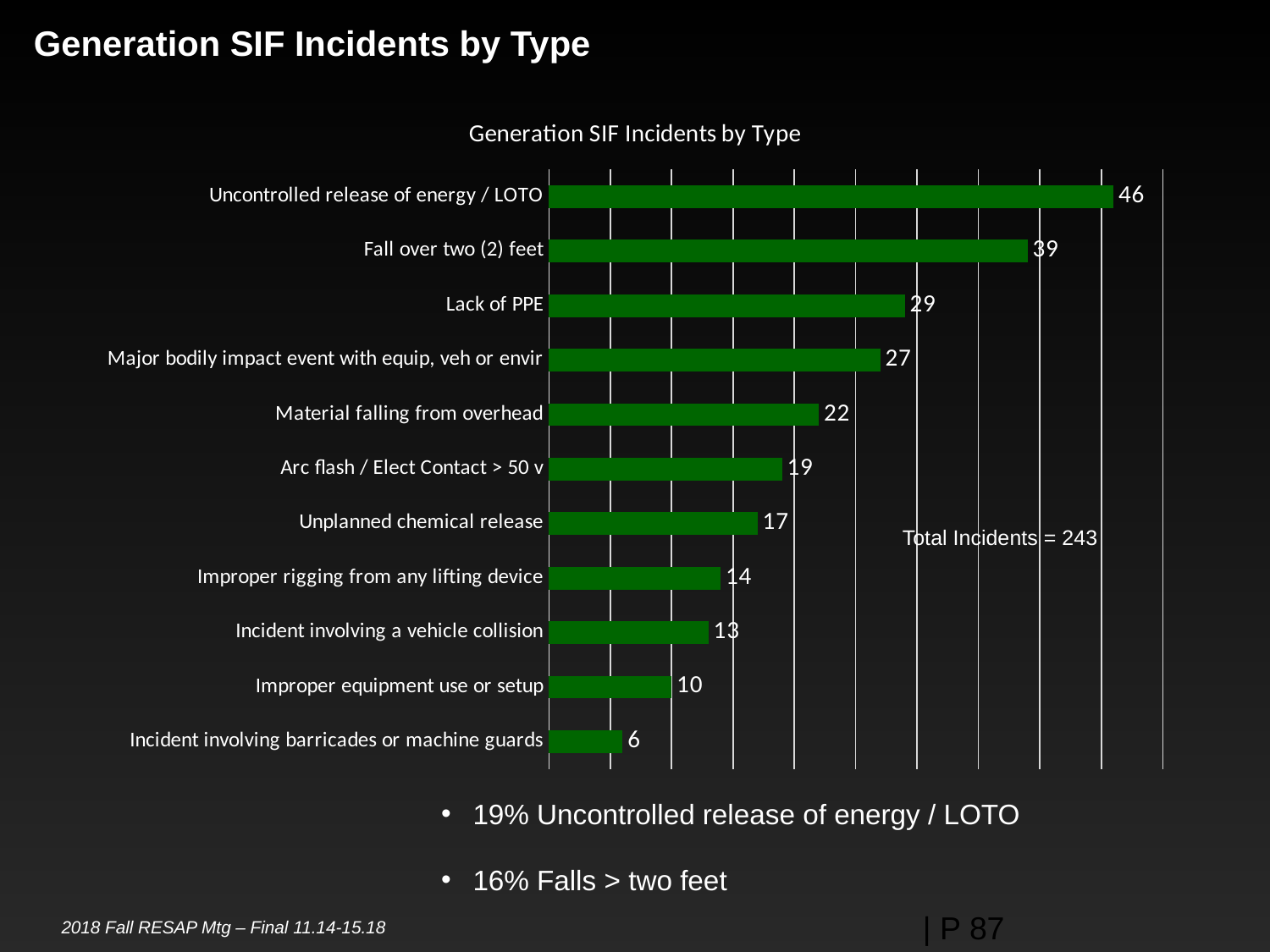
Which category has the lowest value? Incident involving barricades or machine guards What is the difference between the values for Fall over two (2) feet and Lack of PPE? 10 Which is larger, the value for Major bodily impact event with equip, veh or envir or the value for Improper rigging from any lifting device? Major bodily impact event with equip, veh or envir How many categories are shown in the chart? 11 What kind of chart is this? Bar chart What is the value for Improper equipment use or setup? 10 What total number of incidents is stated on the chart? 243 Which category has the highest value? Uncontrolled release of energy / LOTO What is the difference between the values for Arc flash / Elect Contact > 50 v and Unplanned chemical release? 2 What is the title of the chart? Generation SIF Incidents by Type What is the value for Material falling from overhead? 22 What is the value for Uncontrolled release of energy / LOTO? 46